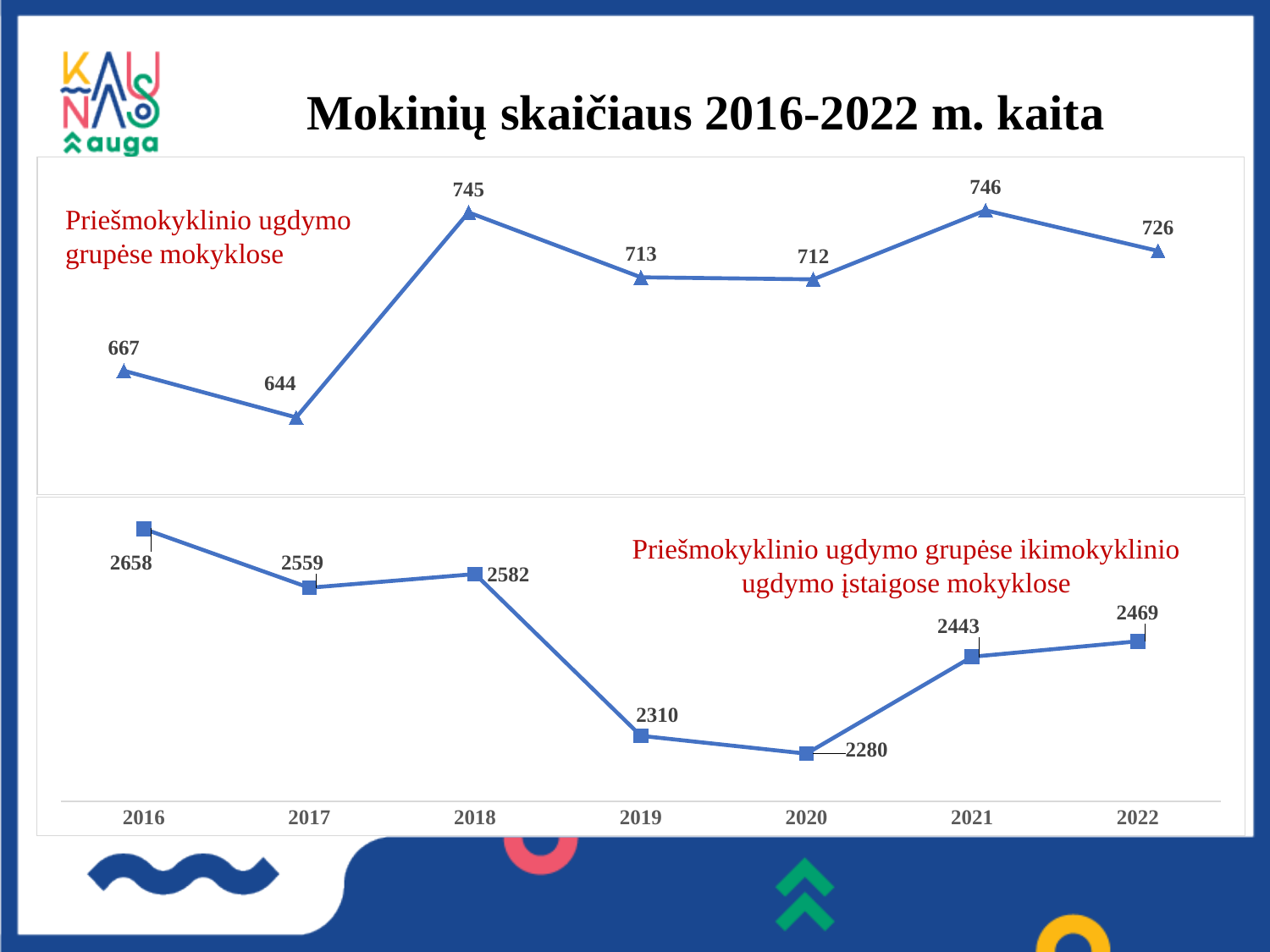
In the top chart (Priešmokyklinio ugdymo grupėse mokyklose), what is the difference between the 2018 value and the 2017 value? 101 In the bottom chart (Priešmokyklinio ugdymo grupėse ikimokyklinio ugdymo įstaigose mokyklose), what is the value for 2020? 2280 In the top chart (Priešmokyklinio ugdymo grupėse mokyklose), which year has the highest value? 2021 In the top chart (Priešmokyklinio ugdymo grupėse mokyklose), what is the value for 2018? 745 In the top chart (Priešmokyklinio ugdymo grupėse mokyklose), what is the value for 2022? 726 What type of chart is the top chart on the slide? Line chart In the bottom chart (Priešmokyklinio ugdymo grupėse ikimokyklinio ugdymo įstaigose mokyklose), which is larger, the value for 2017 or the value for 2018? 2018 In the bottom chart (Priešmokyklinio ugdymo grupėse ikimokyklinio ugdymo įstaigose mokyklose), what is the difference between the 2016 value and the 2022 value? 189 In the bottom chart (Priešmokyklinio ugdymo grupėse ikimokyklinio ugdymo įstaigose mokyklose), which year has the highest value? 2016 How many years (data points) are plotted in the bottom chart? 7 In the top chart (Priešmokyklinio ugdymo grupėse mokyklose), which year has the lowest value? 2017 In the bottom chart (Priešmokyklinio ugdymo grupėse ikimokyklinio ugdymo įstaigose mokyklose), which year has the lowest value? 2020